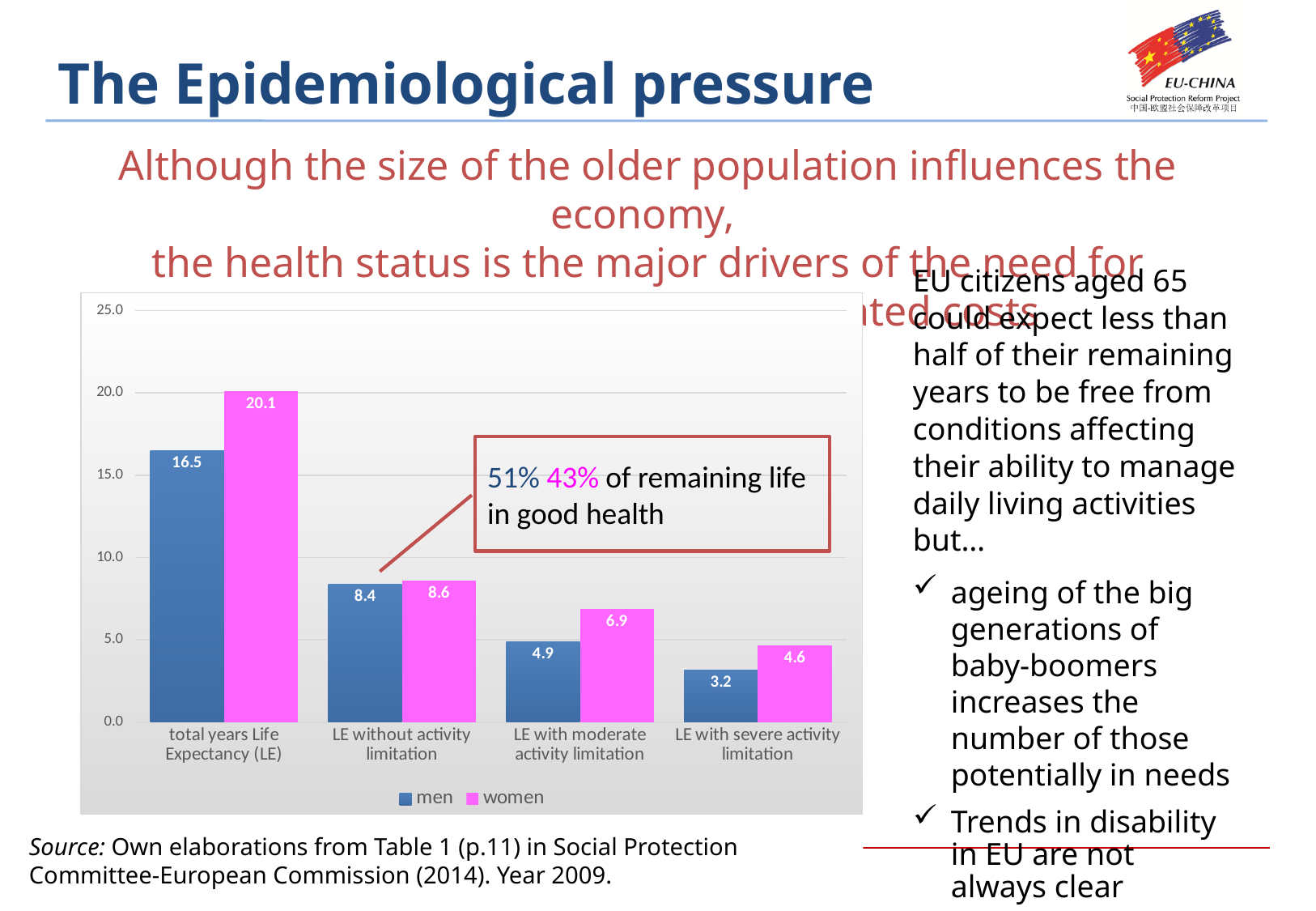
What is the value for women for LE with severe activity limitation? 4.6 What is the value for women for total years Life Expectancy (LE)? 20.1 What is the value for men for LE without activity limitation? 8.4 What is the value for men for LE with moderate activity limitation? 4.9 For LE with severe activity limitation, which is larger, the value for men or for women? women How many categories are shown on the x axis of the chart? 4 What kind of chart is shown on the slide? bar chart Which category has the highest value for men? total years Life Expectancy (LE) What is the difference between the women and men values for LE with moderate activity limitation? 2.0 How many series does the chart's legend list? 2 What is the difference between the women and men values for total years Life Expectancy (LE)? 3.6 Which category has the lowest value for women? LE with severe activity limitation